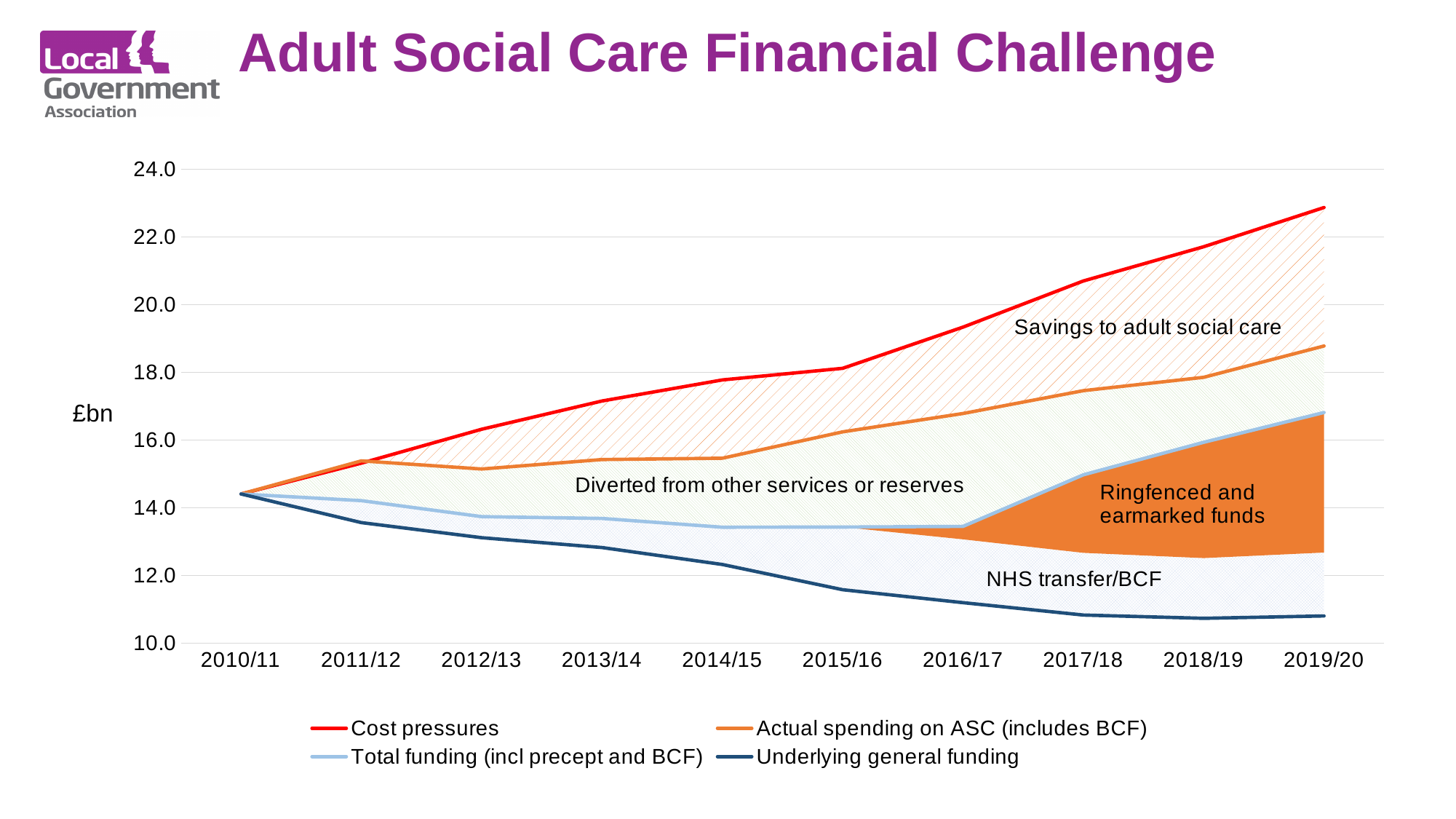
Is the value for Actual spending on ASC (includes BCF) in 2019/20 greater or less than 18.0? greater Which series has the lowest value in 2019/20? Underlying general funding How many series does the legend list? 4 What kind of chart is shown on the slide? Line chart Is the value for Cost pressures in 2019/20 greater or less than 22.0? greater Is the value for Underlying general funding in 2019/20 greater or less than 12.0? less Does the Cost pressures line rise or fall from 2010/11 to 2019/20? Rises Does the Underlying general funding line rise or fall from 2010/11 to 2019/20? Falls What unit is shown on the y axis? £bn Which series has the highest value in 2019/20? Cost pressures How many financial years are shown along the x axis? 10